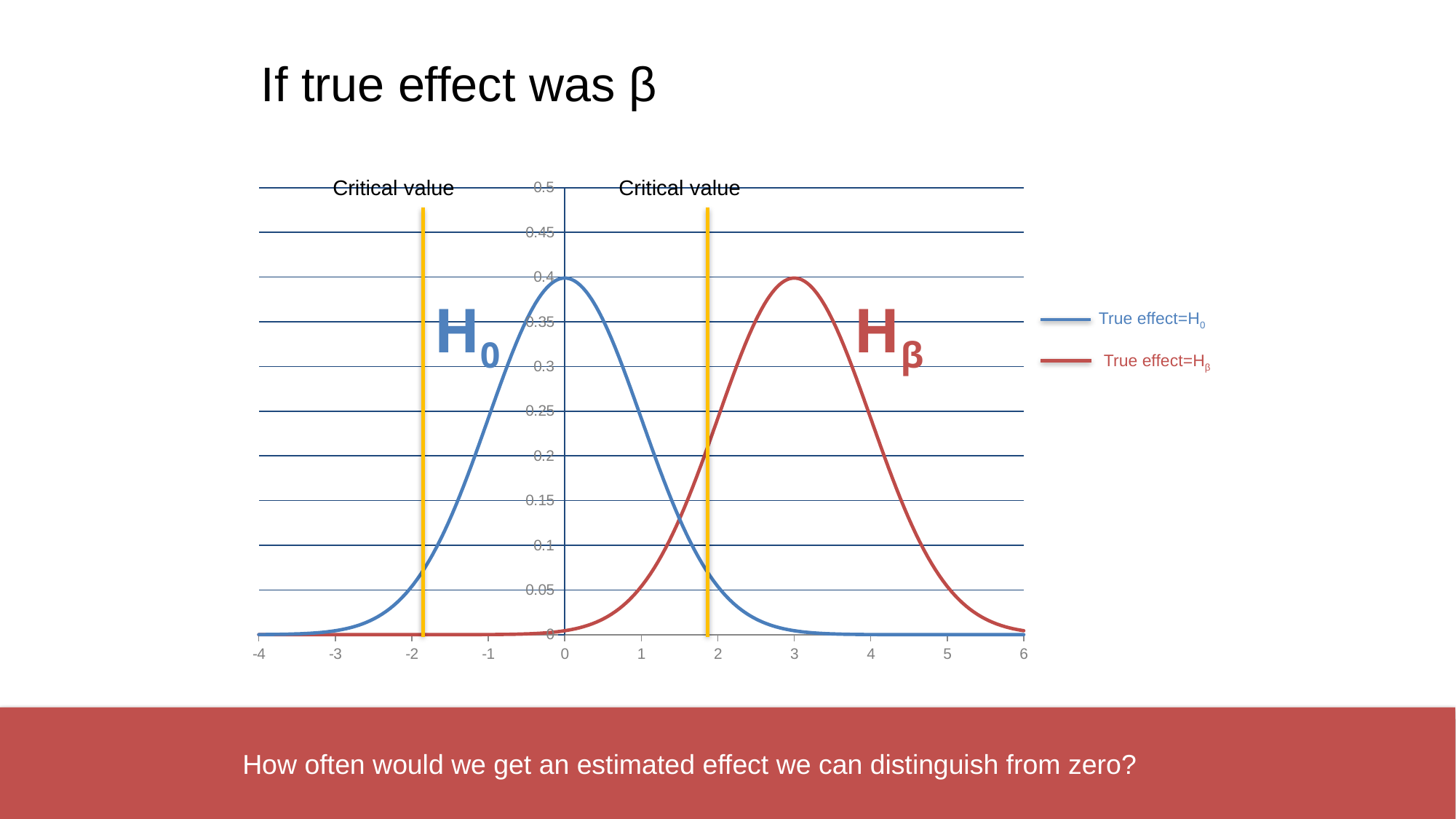
What colour is the curve labelled H0? blue How many tick labels are shown on the x axis? 11 What kind of chart is shown on the slide? line chart At x = 1, which curve is higher, the blue True effect=H0 curve or the red True effect=Hβ curve? True effect=H0 How many series does the legend list? 2 Does the blue True effect=H0 curve rise or fall as x goes from 0 to 6? fall Is the value of the blue True effect=H0 curve at x = 2 greater or less than 0.1? less What are the two legend entries of the chart? True effect=H0 and True effect=Hβ At which x-axis value does the blue True effect=H0 curve reach its peak? 0 At which x-axis value does the red True effect=Hβ curve reach its peak? 3 At x = 4, which curve is higher, the blue True effect=H0 curve or the red True effect=Hβ curve? True effect=Hβ